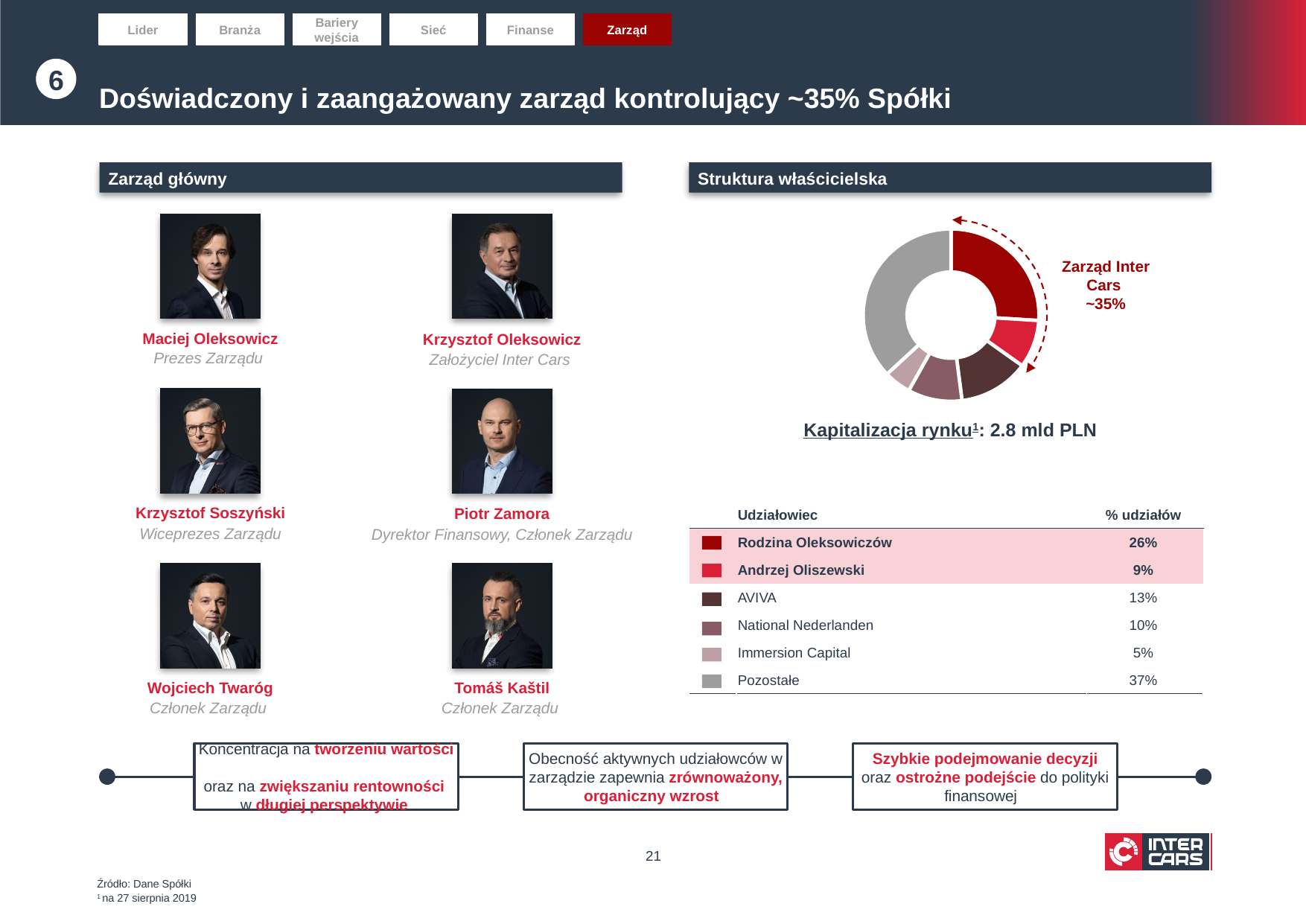
In the ownership structure chart, what share is held by National Nederlanden? 10% Which named shareholder has the smallest share in the ownership structure chart? Immersion Capital In the ownership structure chart, what share is held by Rodzina Oleksowiczów? 26% How many shareholder categories are listed in the ownership structure table? 6 In the ownership structure chart, what share is held by Immersion Capital? 5% Which shareholder category has the largest share in the ownership structure chart? Pozostałe Which holds a larger share: AVIVA or National Nederlanden? AVIVA In the ownership structure chart, what share is held by AVIVA? 13% What market capitalisation is stated below the ownership structure chart? 2.8 mld PLN What is the combined share of Rodzina Oleksowiczów and Andrzej Oliszewski (the highlighted rows)? 35% What is the difference between the shares of Rodzina Oleksowiczów and Andrzej Oliszewski? 17% What kind of chart is shown under "Struktura właścicielska"? Donut (pie) chart